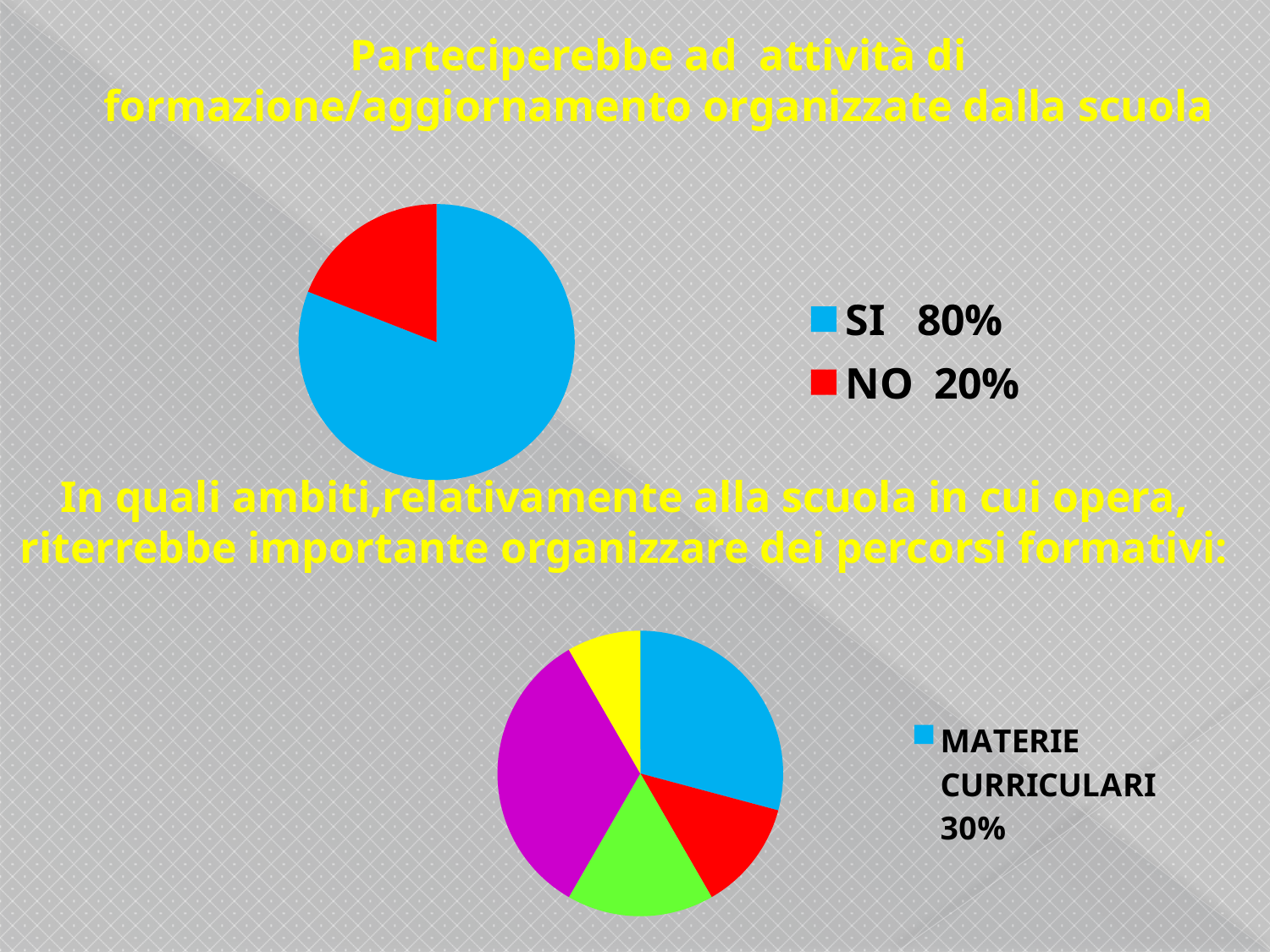
What type of chart is the top chart on the slide? Pie chart In the top pie chart, which response has the smallest share? NO In the top pie chart, which response has the largest share? SI In the top pie chart, how many entries does the legend list? 2 What type of chart is the bottom chart on the slide? Pie chart In the top pie chart, what is the difference in percentage points between SI and NO? 60 In the top pie chart, what percentage answered SI? 80% In the bottom pie chart, what share is MATERIE CURRICULARI? 30% In the top pie chart, which is larger, SI or NO? SI In the top pie chart, what colour is the SI slice? Blue How many slices does the bottom pie chart have? 5 In the top pie chart, what percentage answered NO? 20%